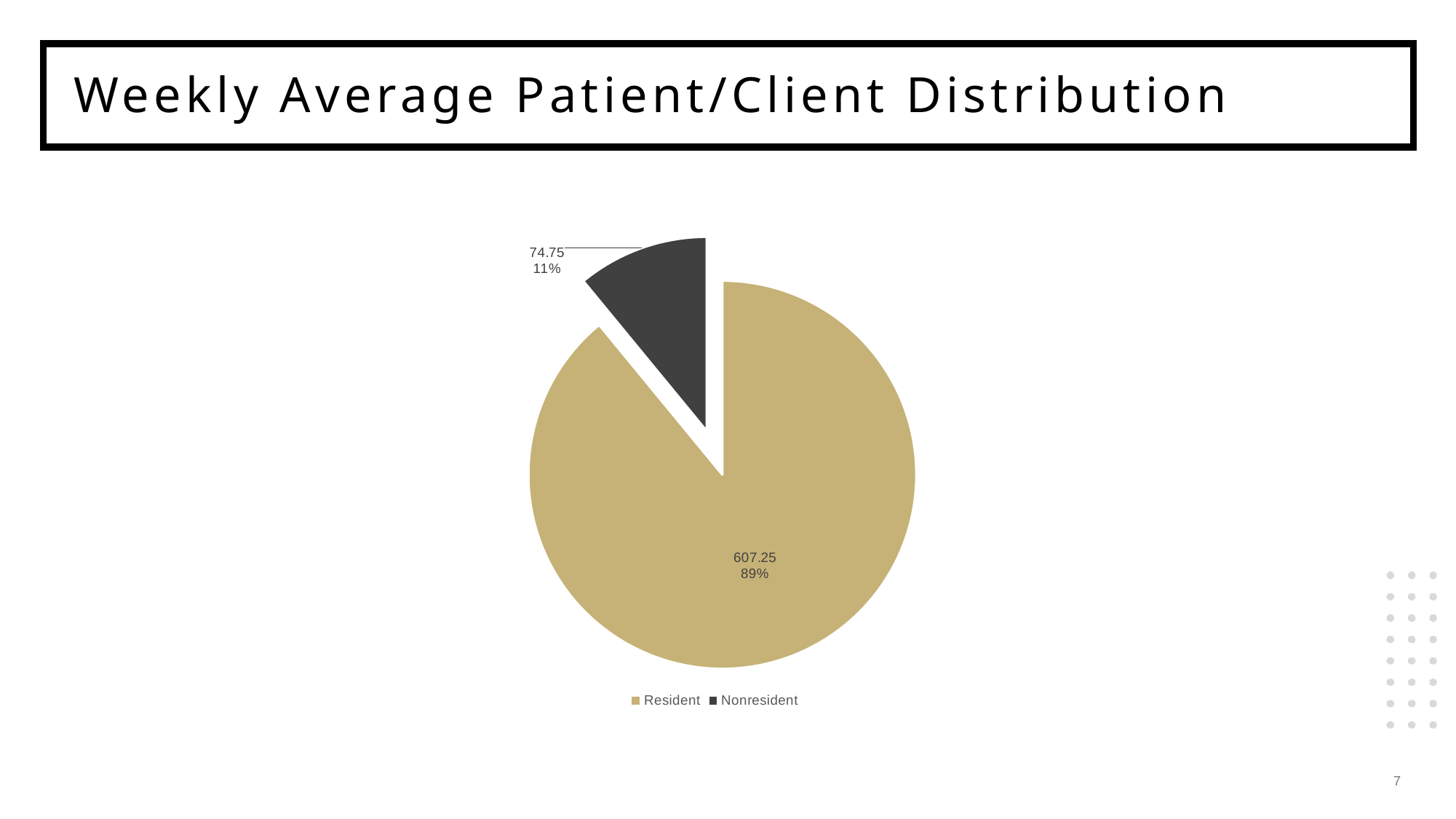
What is the value for Nonresident? 74.75 What is the title of the slide containing the chart? Weekly Average Patient/Client Distribution What kind of chart is shown on the slide? Pie chart Which category has the largest slice? Resident What share of the pie does the Nonresident slice represent? 11% What is the value for Resident? 607.25 How many categories does the pie chart have? 2 Which slice is pulled out from the pie? Nonresident What is the difference between the Resident and Nonresident values? 532.5 Which category has the smallest slice? Nonresident Which is larger, the Resident value or the Nonresident value? Resident What share of the pie does the Resident slice represent? 89%